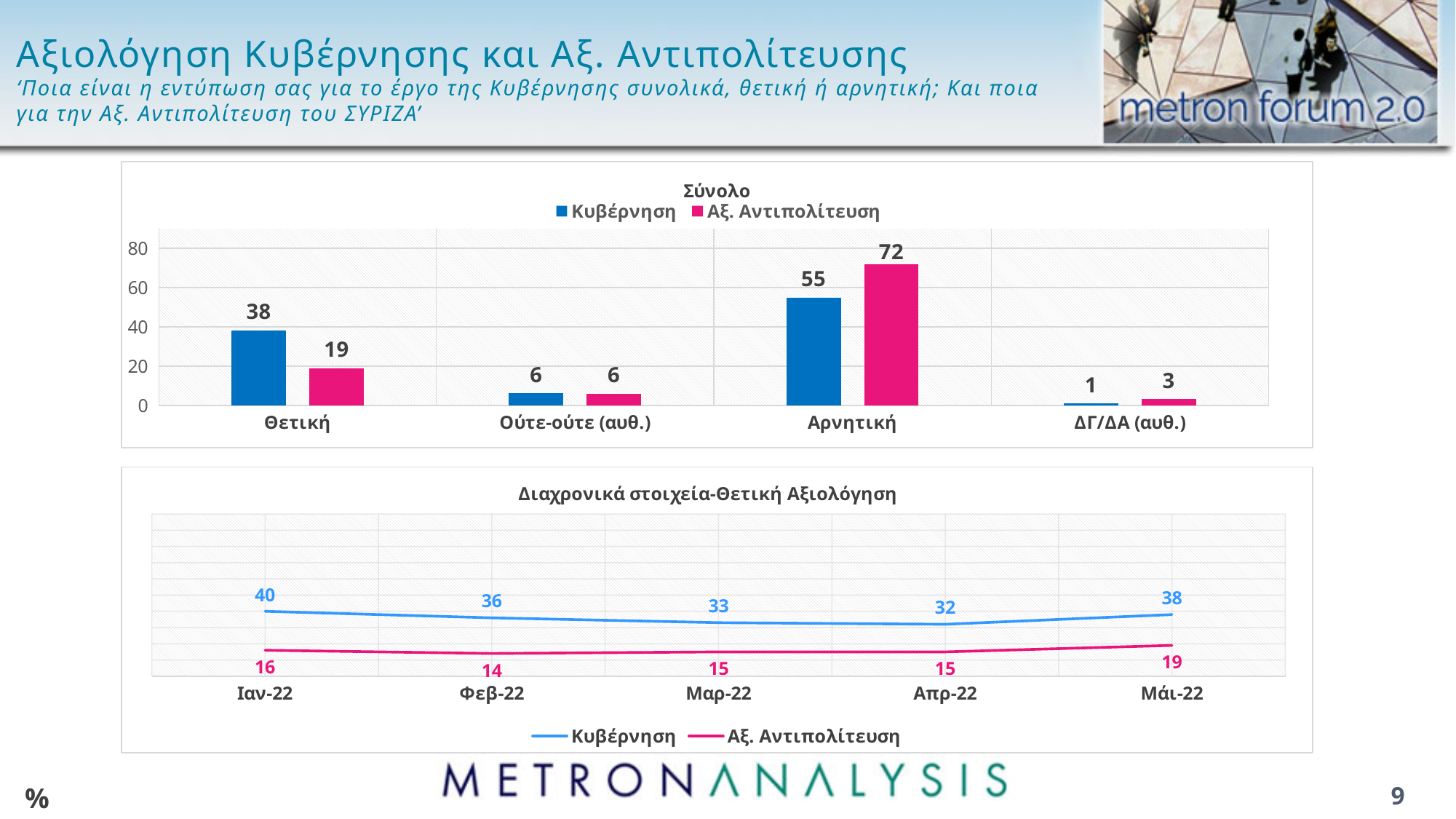
In the 'Σύνολο' chart, which category has the lowest value for Αξ. Αντιπολίτευση? ΔΓ/ΔΑ (αυθ.) What type of chart is the 'Σύνολο' chart? Bar chart In the 'Σύνολο' chart, what is the value for Κυβέρνηση in the Θετική category? 38 How many series does the legend of the 'Διαχρονικά στοιχεία-Θετική Αξιολόγηση' chart list? 2 In the 'Σύνολο' chart, what is the value for Αξ. Αντιπολίτευση in the Αρνητική category? 72 In the 'Σύνολο' chart, what is the difference between the Αξ. Αντιπολίτευση and Κυβέρνηση values in the Αρνητική category? 17 In the 'Σύνολο' chart, which is larger in the Θετική category: Κυβέρνηση or Αξ. Αντιπολίτευση? Κυβέρνηση In the 'Διαχρονικά στοιχεία-Θετική Αξιολόγηση' chart, what is the difference between the Κυβέρνηση and Αξ. Αντιπολίτευση values in Ιαν-22? 24 In the 'Σύνολο' chart, how many categories are shown on the x axis? 4 In the 'Διαχρονικά στοιχεία-Θετική Αξιολόγηση' chart, which month has the lowest value for Αξ. Αντιπολίτευση? Φεβ-22 In the 'Σύνολο' chart, which category has the highest value for Κυβέρνηση? Αρνητική In the 'Διαχρονικά στοιχεία-Θετική Αξιολόγηση' chart, what is the value for Κυβέρνηση in Απρ-22? 32